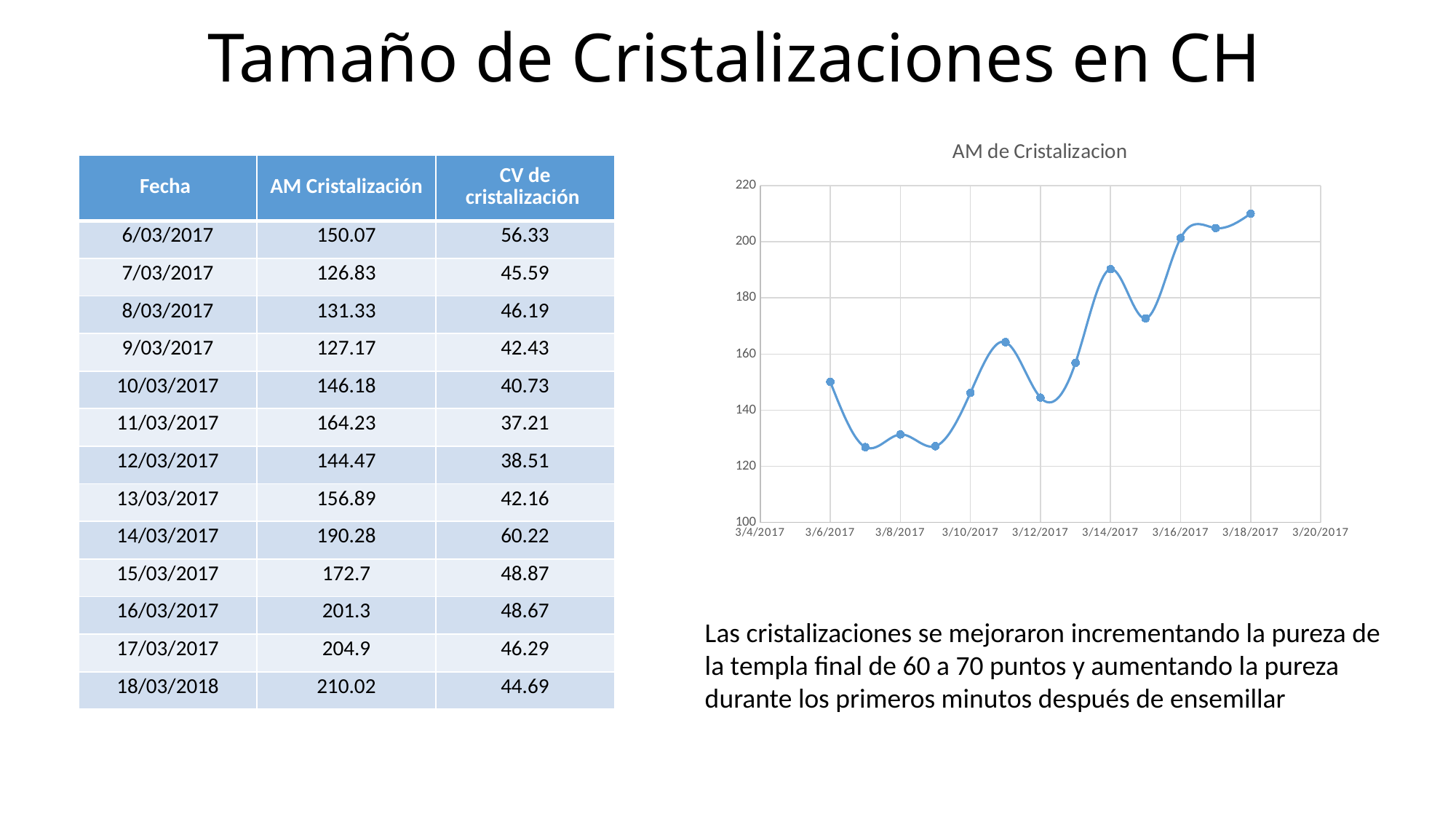
According to the table on the slide, what is the AM Cristalización value for 6/03/2017? 150.07 Is the value plotted for 3/15/2017 greater or less than 180? less Is the value plotted for 3/14/2017 greater or less than 180? greater Which is larger, the value for 3/14/2017 or the value for 3/15/2017? 3/14/2017 Using the table values, what is the difference between the AM Cristalización on 18/03 (210.02) and on 6/03/2017 (150.07)? 59.95 How many data points are plotted on the line chart? 13 Is the value plotted for 3/6/2017 greater or less than 160? less What is the title of the chart? AM de Cristalizacion According to the table on the slide, what is the AM Cristalización value for 14/03/2017? 190.28 What kind of chart is shown on the slide? line chart Do the values in the chart generally rise or fall from left to right? rise On which date does the line chart reach its highest value? 3/18/2017